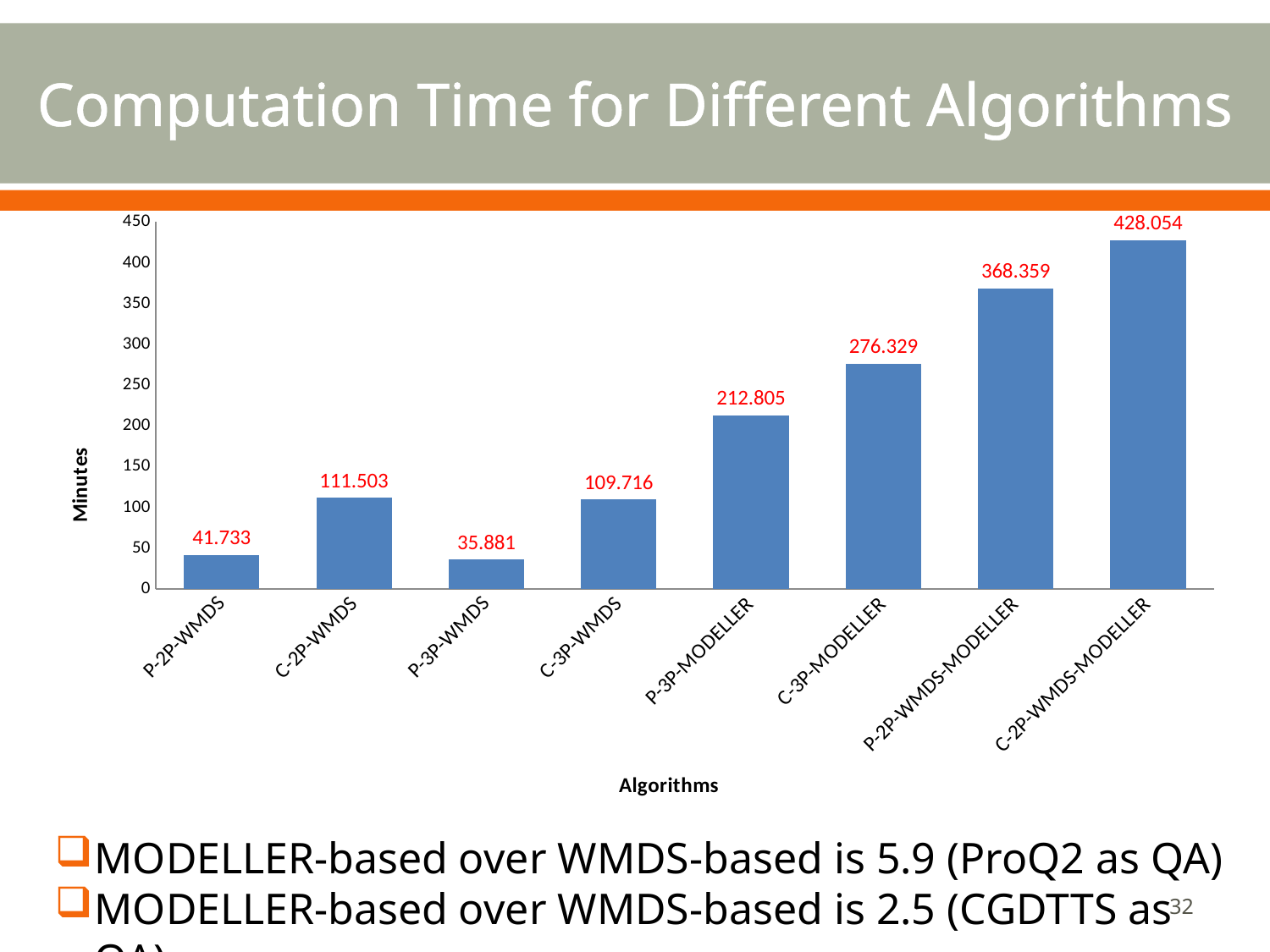
Which algorithm has the highest computation time? C-2P-WMDS-MODELLER How many algorithms are shown on the x axis? 8 What is the difference in minutes between C-2P-WMDS-MODELLER and P-2P-WMDS-MODELLER? 59.695 What is the computation time in minutes for C-2P-WMDS? 111.503 Which has a larger computation time, P-2P-WMDS or C-3P-MODELLER? C-3P-MODELLER Which algorithm has the lowest computation time? P-3P-WMDS What is the computation time in minutes for P-3P-MODELLER? 212.805 What is the computation time in minutes for C-2P-WMDS-MODELLER? 428.054 What kind of chart is shown on the slide? bar chart What is the label of the y axis? Minutes What is the difference in minutes between C-3P-MODELLER and P-3P-MODELLER? 63.524 Is the computation time for P-2P-WMDS-MODELLER greater or less than 350 minutes? greater